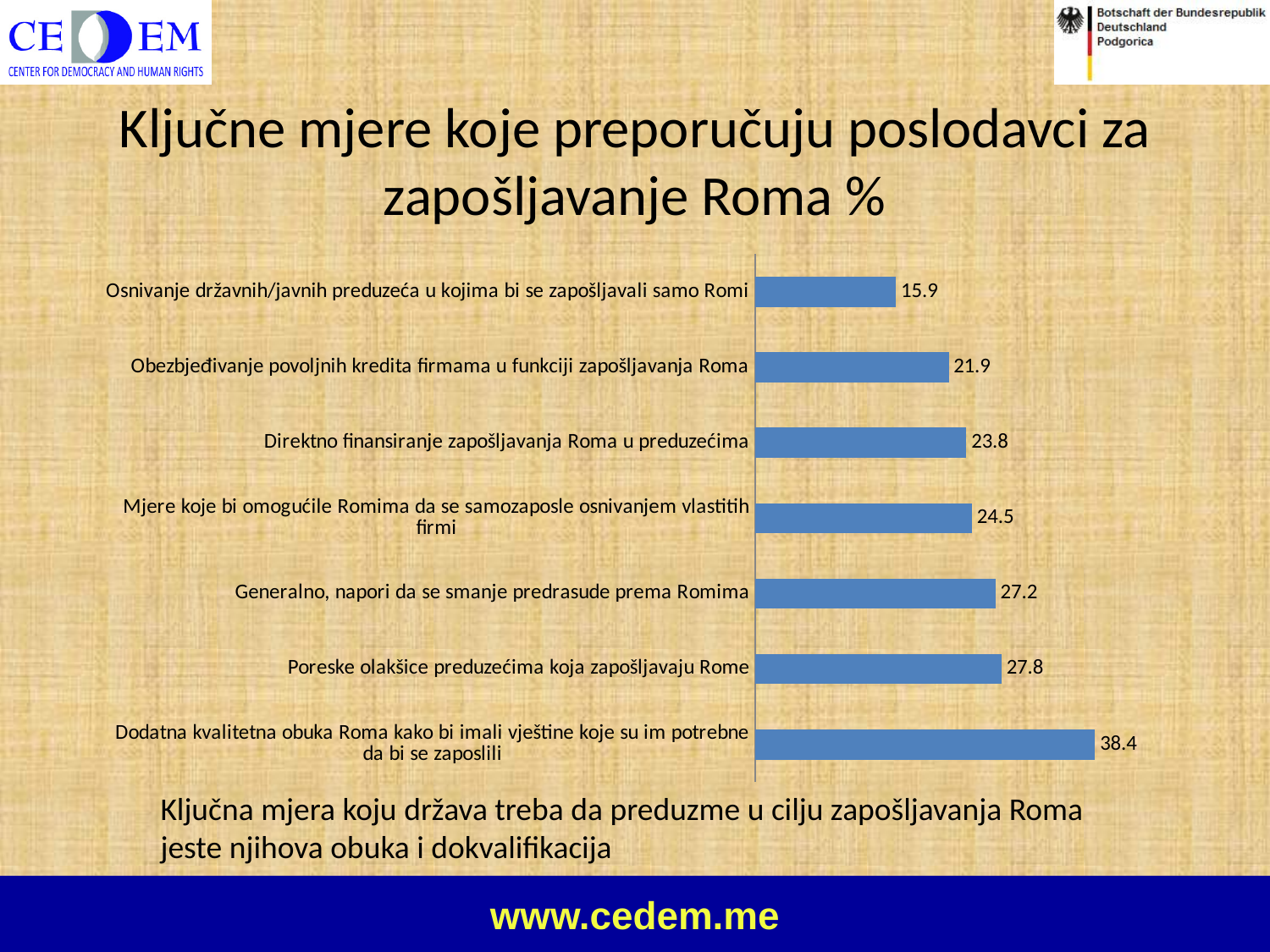
Which is larger: the value for "Mjere koje bi omogućile Romima da se samozaposle osnivanjem vlastitih firmi" or for "Direktno finansiranje zapošljavanja Roma u preduzećima"? Mjere koje bi omogućile Romima da se samozaposle osnivanjem vlastitih firmi What is the value for "Dodatna kvalitetna obuka Roma kako bi imali vještine koje su im potrebne da bi se zaposlili"? 38.4 How many categories are shown in the chart? 7 What kind of chart is shown on the slide? Bar chart What is the title of the chart on the slide? Ključne mjere koje preporučuju poslodavci za zapošljavanje Roma % What is the difference between the values for "Generalno, napori da se smanje predrasude prema Romima" and "Obezbjeđivanje povoljnih kredita firmama u funkciji zapošljavanja Roma"? 5.3 Which category has the highest value? Dodatna kvalitetna obuka Roma kako bi imali vještine koje su im potrebne da bi se zaposlili What is the value for "Poreske olakšice preduzećima koja zapošljavaju Rome"? 27.8 What is the difference between the values for "Dodatna kvalitetna obuka Roma..." and "Osnivanje državnih/javnih preduzeća..."? 22.5 What is the value for "Osnivanje državnih/javnih preduzeća u kojima bi se zapošljavali samo Romi"? 15.9 What is the value for "Direktno finansiranje zapošljavanja Roma u preduzećima"? 23.8 Which category has the lowest value? Osnivanje državnih/javnih preduzeća u kojima bi se zapošljavali samo Romi